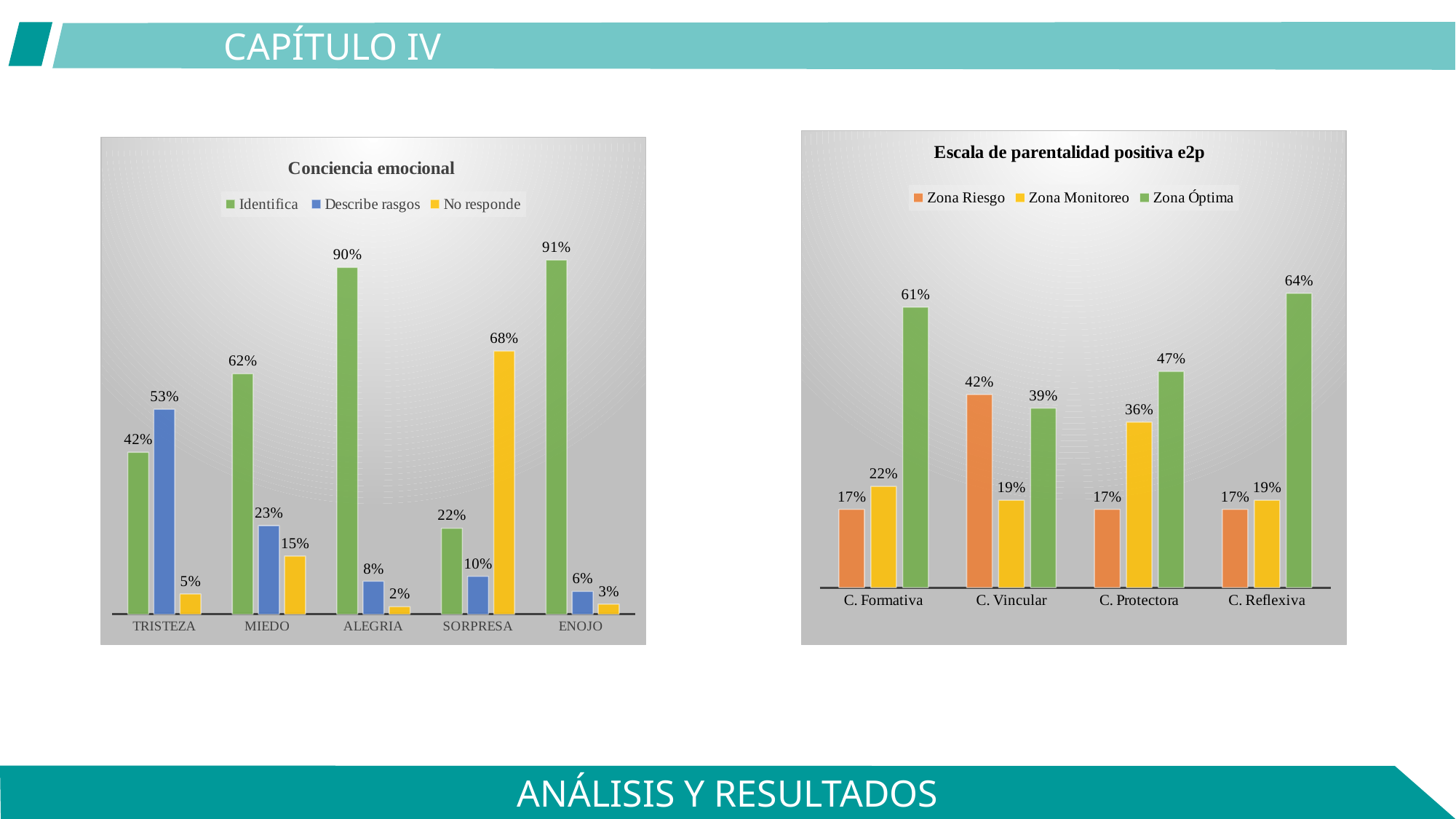
In the 'Escala de parentalidad positiva e2p' chart, what is the difference between the 'Zona Óptima' values for C. Formativa and C. Vincular? 22% In the 'Conciencia emocional' chart, which category has the lowest 'Describe rasgos' value? ENOJO In the 'Escala de parentalidad positiva e2p' chart, which category has the highest 'Zona Riesgo' value? C. Vincular In the 'Escala de parentalidad positiva e2p' chart, what is the 'Zona Óptima' value for C. Reflexiva? 64% In the 'Escala de parentalidad positiva e2p' chart, which is larger for C. Protectora: 'Zona Monitoreo' or 'Zona Óptima'? Zona Óptima In the 'Conciencia emocional' chart, what is the difference between the 'Identifica' values for MIEDO and TRISTEZA? 20% What type of chart is 'Escala de parentalidad positiva e2p'? Bar chart In the 'Conciencia emocional' chart, what is the 'Identifica' value for ALEGRIA? 90% In the 'Conciencia emocional' chart, which category has the highest 'Identifica' value? ENOJO In the 'Conciencia emocional' chart, what is the 'No responde' value for SORPRESA? 68% In the 'Conciencia emocional' chart, how many categories are shown on the x axis? 5 In the 'Conciencia emocional' chart, how many series does the legend list? 3